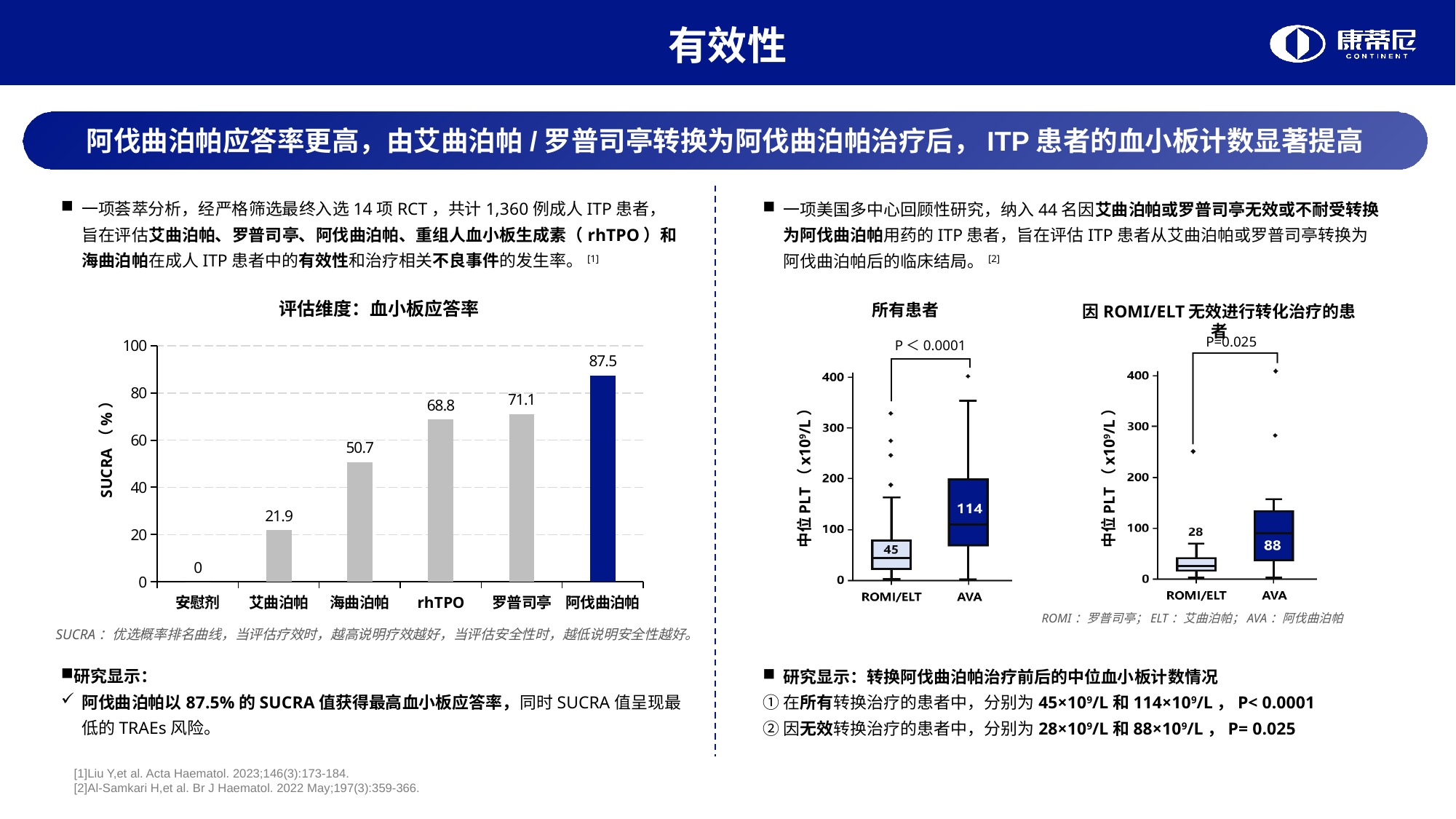
In the bar chart titled 评估维度：血小板应答率, which has a larger SUCRA value, rhTPO or 艾曲泊帕? rhTPO In the bar chart titled 评估维度：血小板应答率, do the SUCRA values rise or fall from left to right along the x axis? rise In the bar chart titled 评估维度：血小板应答率, how many categories are shown on the x axis? 6 In the bar chart titled 评估维度：血小板应答率, what is the SUCRA value for 海曲泊帕? 50.7 In the box plot titled 因 ROMI/ELT 无效进行转化治疗的患者, what is the median PLT value labelled for ROMI/ELT? 28 What kind of chart is the chart titled 评估维度：血小板应答率? bar chart In the box plot titled 所有患者, what is the difference between the labelled median PLT values for AVA and ROMI/ELT? 69 In the bar chart titled 评估维度：血小板应答率, what is the SUCRA value for 阿伐曲泊帕? 87.5 In the bar chart titled 评估维度：血小板应答率, what is the difference between the SUCRA values of 阿伐曲泊帕 and 罗普司亭? 16.4 In the bar chart titled 评估维度：血小板应答率, which category has the lowest SUCRA value? 安慰剂 In the bar chart titled 评估维度：血小板应答率, which category has the highest SUCRA value? 阿伐曲泊帕 In the box plot titled 所有患者, what is the median PLT value labelled for AVA? 114